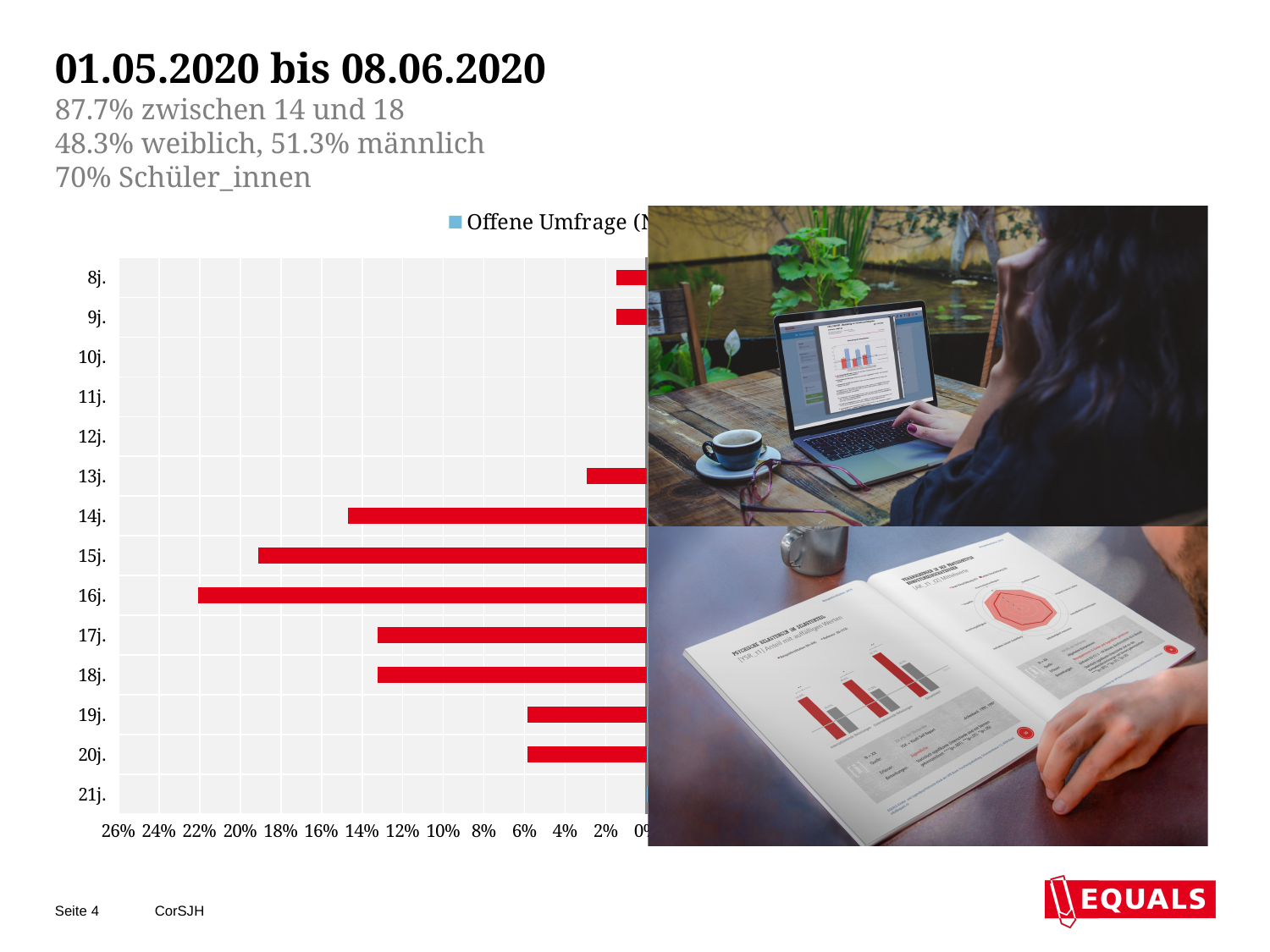
Is the value for 13j. greater or less than 4%? less Which age category has the longest bar in the chart? 16j. Is the value for 15j. greater or less than 16%? greater Is the value for 14j. greater or less than 12%? greater What kind of chart is shown on the slide? bar chart How many age categories are listed on the vertical axis of the chart? 14 Which has the larger value, 15j. or 19j.? 15j. What is the leftmost tick label on the horizontal axis of the chart? 26% Which has the larger value, 16j. or 15j.? 16j.